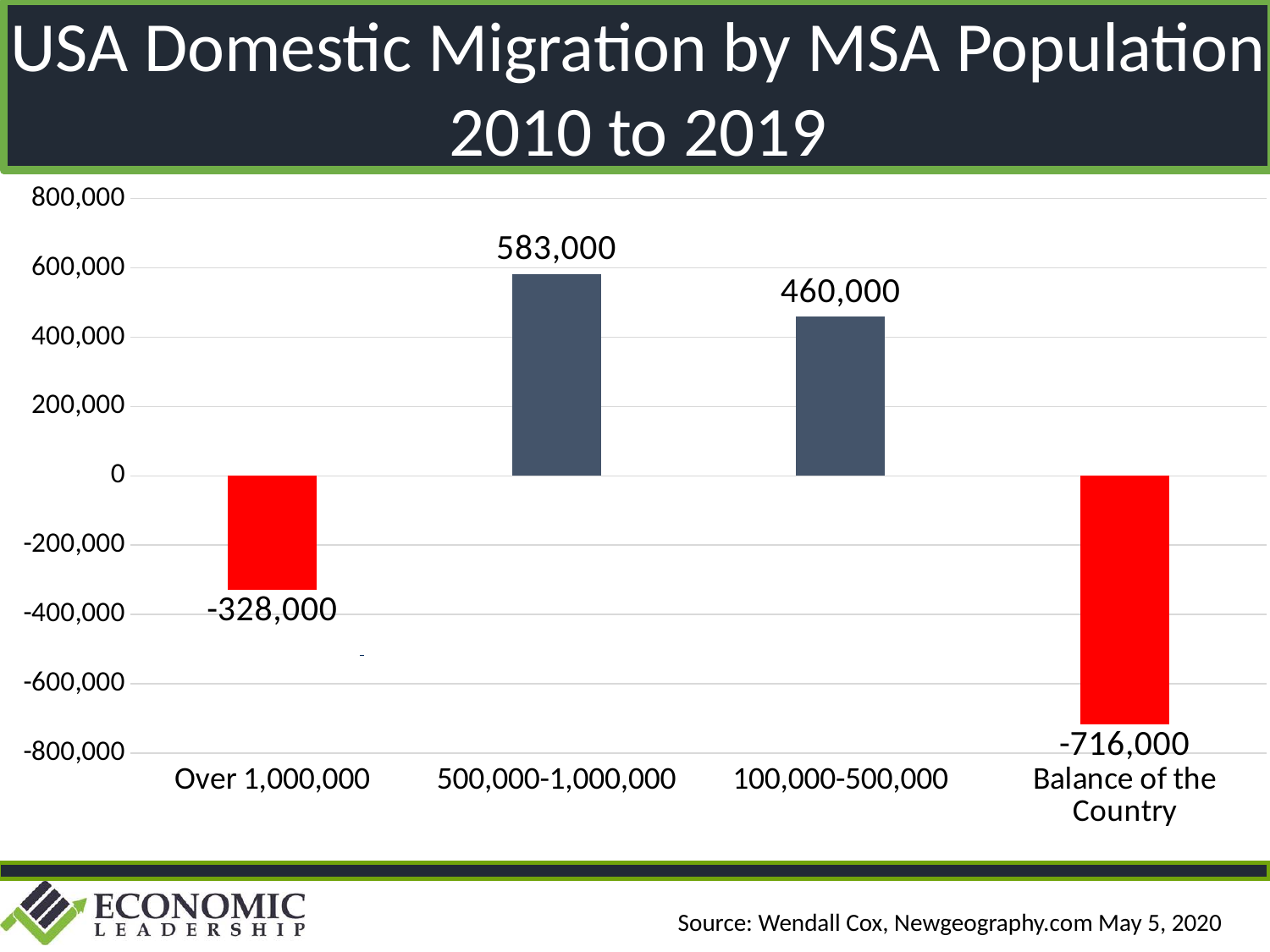
What is the domestic migration value for the 500,000-1,000,000 MSA population category? 583,000 What is the difference between the values for 500,000-1,000,000 and 100,000-500,000? 123,000 Which is larger, the value for 100,000-500,000 or the value for Over 1,000,000? 100,000-500,000 What is the title of the chart? USA Domestic Migration by MSA Population 2010 to 2019 Which category has the highest domestic migration value? 500,000-1,000,000 What kind of chart is shown on the slide? Bar chart How many categories are shown on the x axis? 4 What is the value for the 100,000-500,000 category? 460,000 What is the value shown for Balance of the Country? -716,000 What colour are the bars with negative values? Red Which category has the lowest domestic migration value? Balance of the Country What is the domestic migration value for the Over 1,000,000 category? -328,000